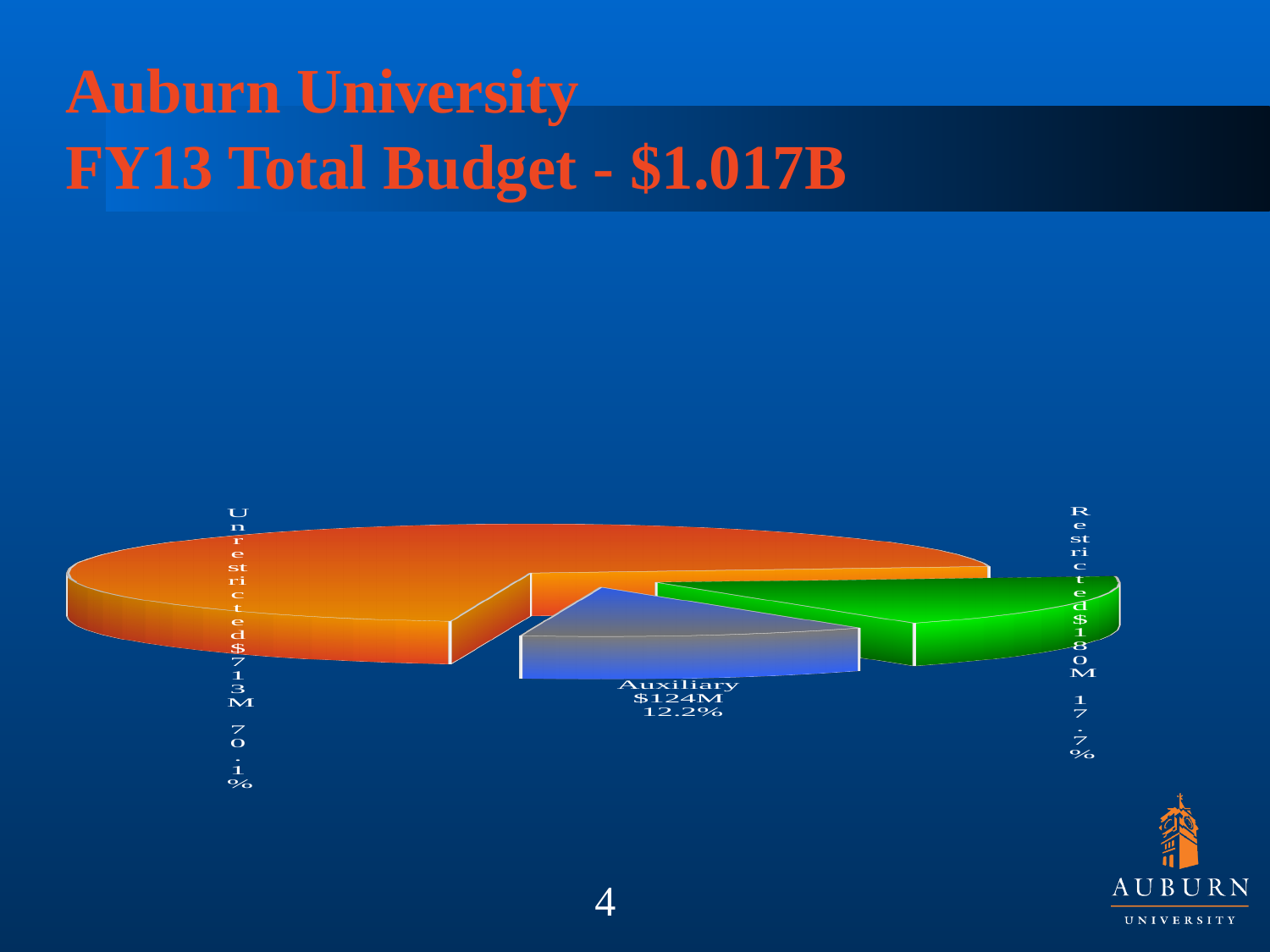
What share of the pie does the Restricted slice represent? 17.7% What is the dollar value of the Restricted slice? $180M What kind of chart is shown on the slide? pie chart Which is larger, the Restricted slice or the Auxiliary slice? Restricted What is the dollar value of the Unrestricted slice? $713M What is the difference in dollars between the Restricted and Auxiliary slices? $56M What is the dollar value of the Auxiliary slice? $124M Which slice of the pie is the smallest? Auxiliary What share of the pie does the Auxiliary slice represent? 12.2% Which slice of the pie is the largest? Unrestricted How many slices does the pie chart have? 3 What share of the pie does the Unrestricted slice represent? 70.1%